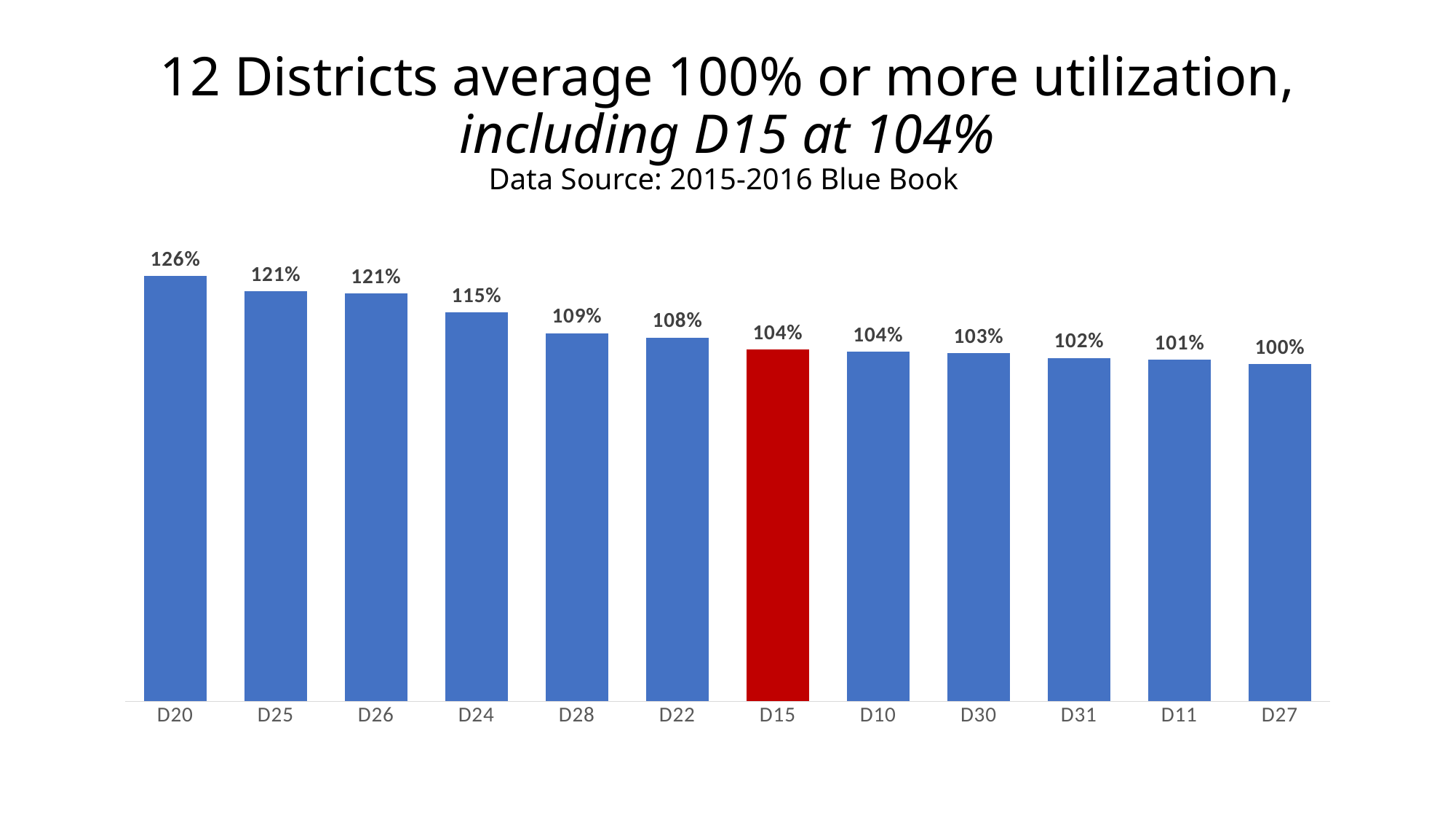
How many districts are shown in the chart? 12 Which district has the highest utilization? D20 What is the utilization value for D20? 126% What is the utilization value for D28? 109% Which has a higher utilization, D22 or D30? D22 What is the difference between the utilization of D20 and D27? 26% Which district's bar is coloured red? D15 What is the utilization value for D15? 104% Do the values rise or fall from left to right along the x axis? Fall Which district has the lowest utilization? D27 What is the difference between the utilization of D24 and D15? 11% What kind of chart is shown on the slide? Bar chart